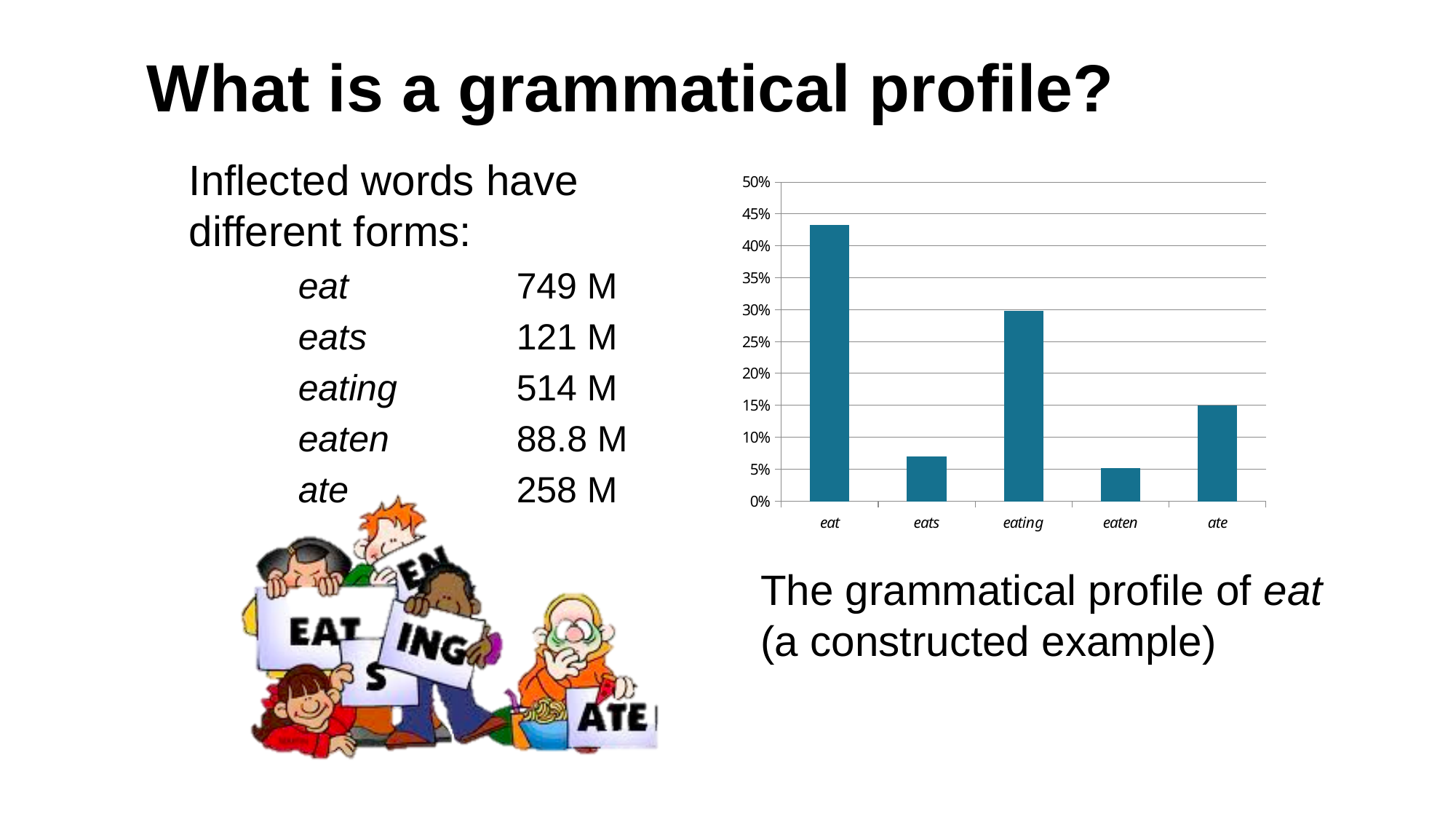
What is the label of the second category from the left on the x axis? eats Which has a larger value in the chart, eating or ate? eating How many categories are shown on the x axis of the chart? 5 Which category has the highest bar in the chart? eat Which category has the lowest bar in the chart? eaten Which has a larger value in the chart, eats or ate? ate Is the value for eating greater or less than 25%? greater Is the value for eats greater or less than 10%? less Is the value for eat greater or less than 40%? greater What is the highest value shown on the chart's y axis? 50% What kind of chart is shown on the slide? bar chart